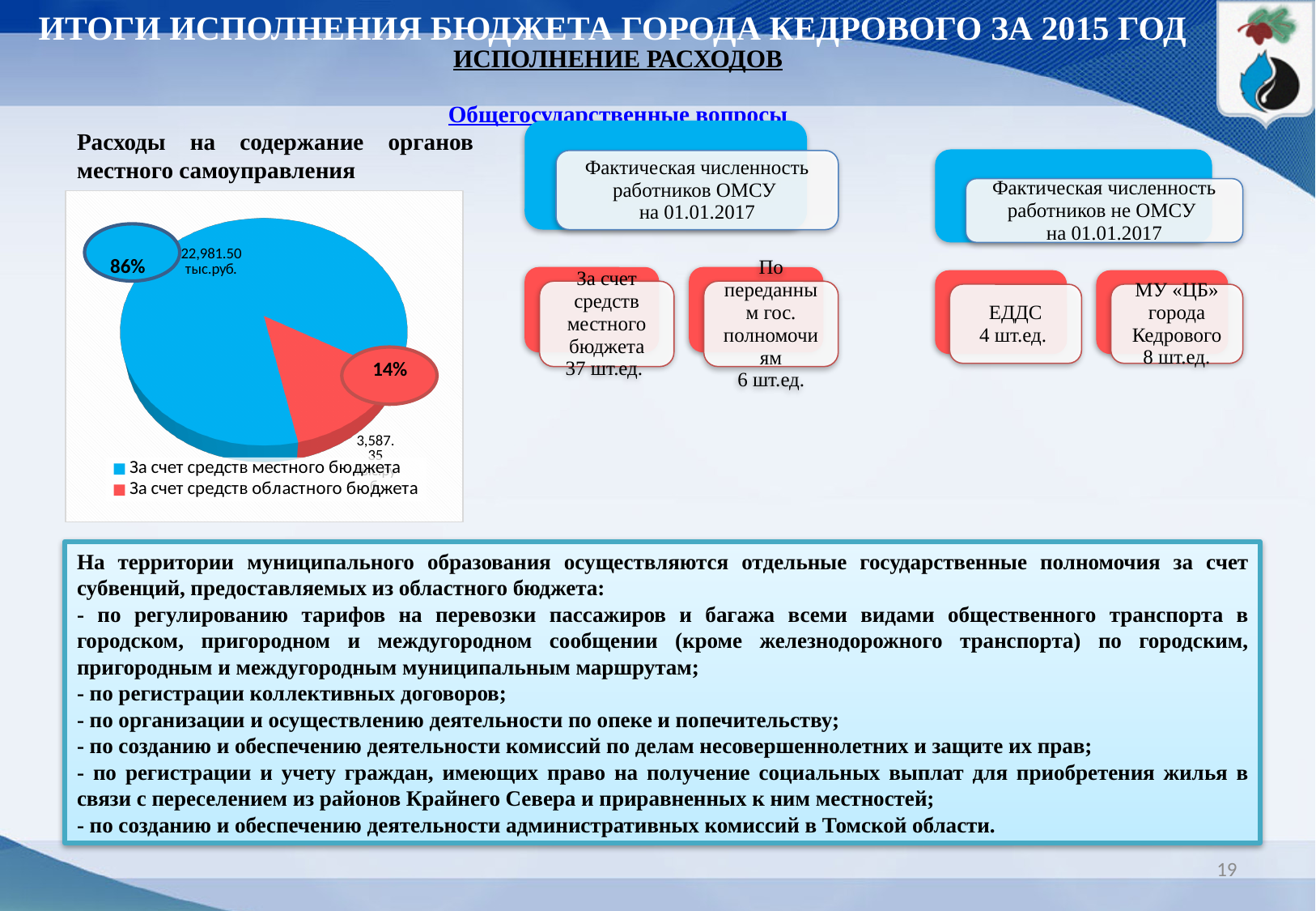
What share of the pie does "За счет средств местного бюджета" take? 86% What share of the pie does "За счет средств областного бюджета" take? 14% By how many percentage points does the share of "За счет средств местного бюджета" exceed the share of "За счет средств областного бюджета"? 72 percentage points How many entries does the legend of the pie chart list? 2 Which slice of the pie chart is the smallest? За счет средств областного бюджета Which is larger in the pie chart: the share for "За счет средств местного бюджета" or for "За счет средств областного бюджета"? За счет средств местного бюджета What value is printed on the pie chart for "За счет средств местного бюджета"? 22,981.50 тыс.руб. How many slices does the pie chart have? 2 Which slice of the pie chart is the largest? За счет средств местного бюджета What colour is the slice for "За счет средств местного бюджета" in the pie chart? blue What is the heading printed above the pie chart? Расходы на содержание органов местного самоуправления What kind of chart is shown on the slide? pie chart